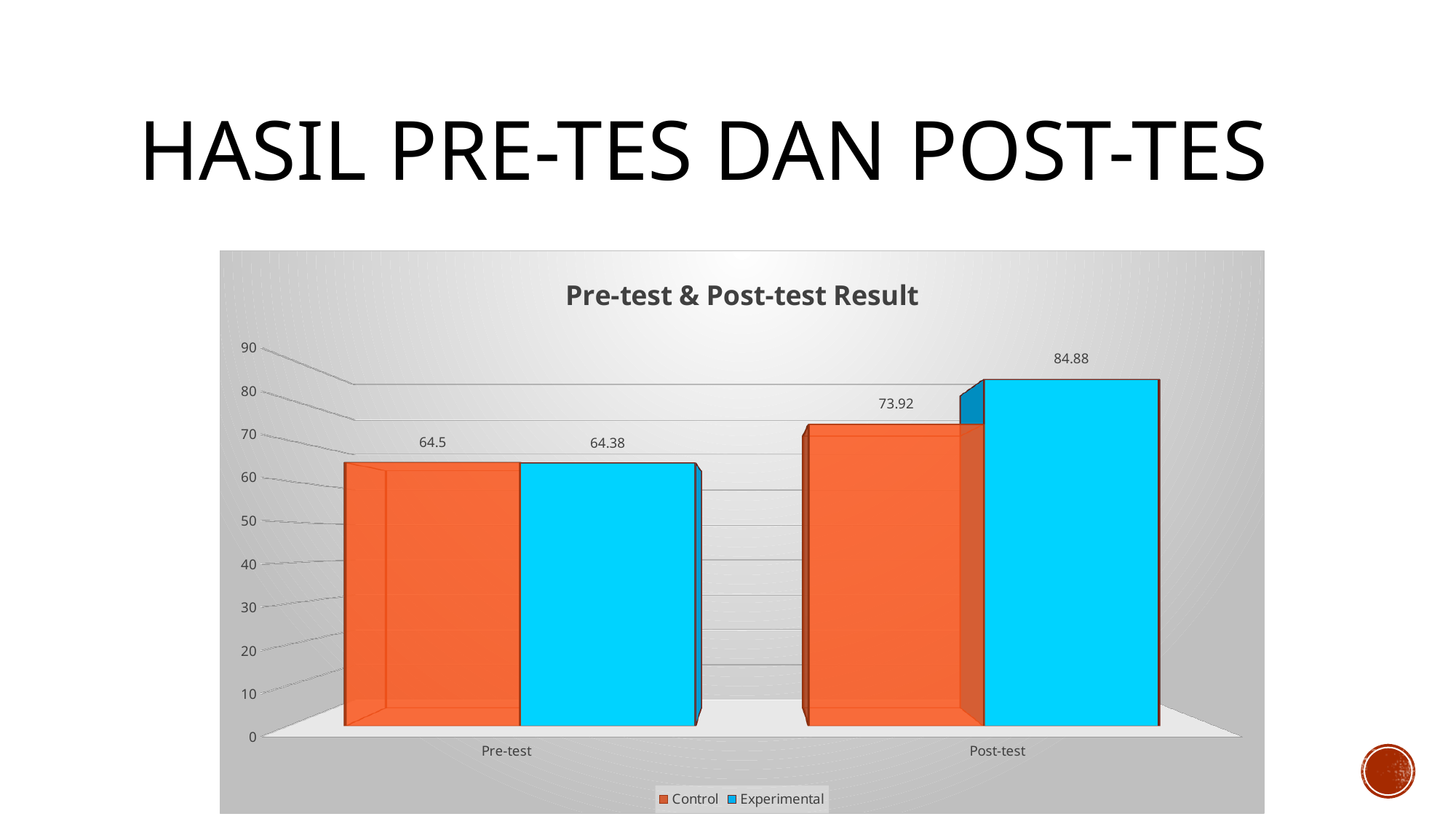
What is the Control value for Post-test? 73.92 What type of chart is shown? Bar chart What is the difference between the Experimental Post-test and Pre-test values? 20.5 What is the Experimental value for Post-test? 84.88 What is the Control value for Pre-test? 64.5 How many categories are shown on the x axis? 2 Which category has the highest Experimental value? Post-test What is the difference between the Experimental and Control values for Post-test? 10.96 How many series does the legend list? 2 What is the Experimental value for Pre-test? 64.38 Is the Control value for Post-test greater or less than 70? greater For Post-test, which series has the larger value, Control or Experimental? Experimental